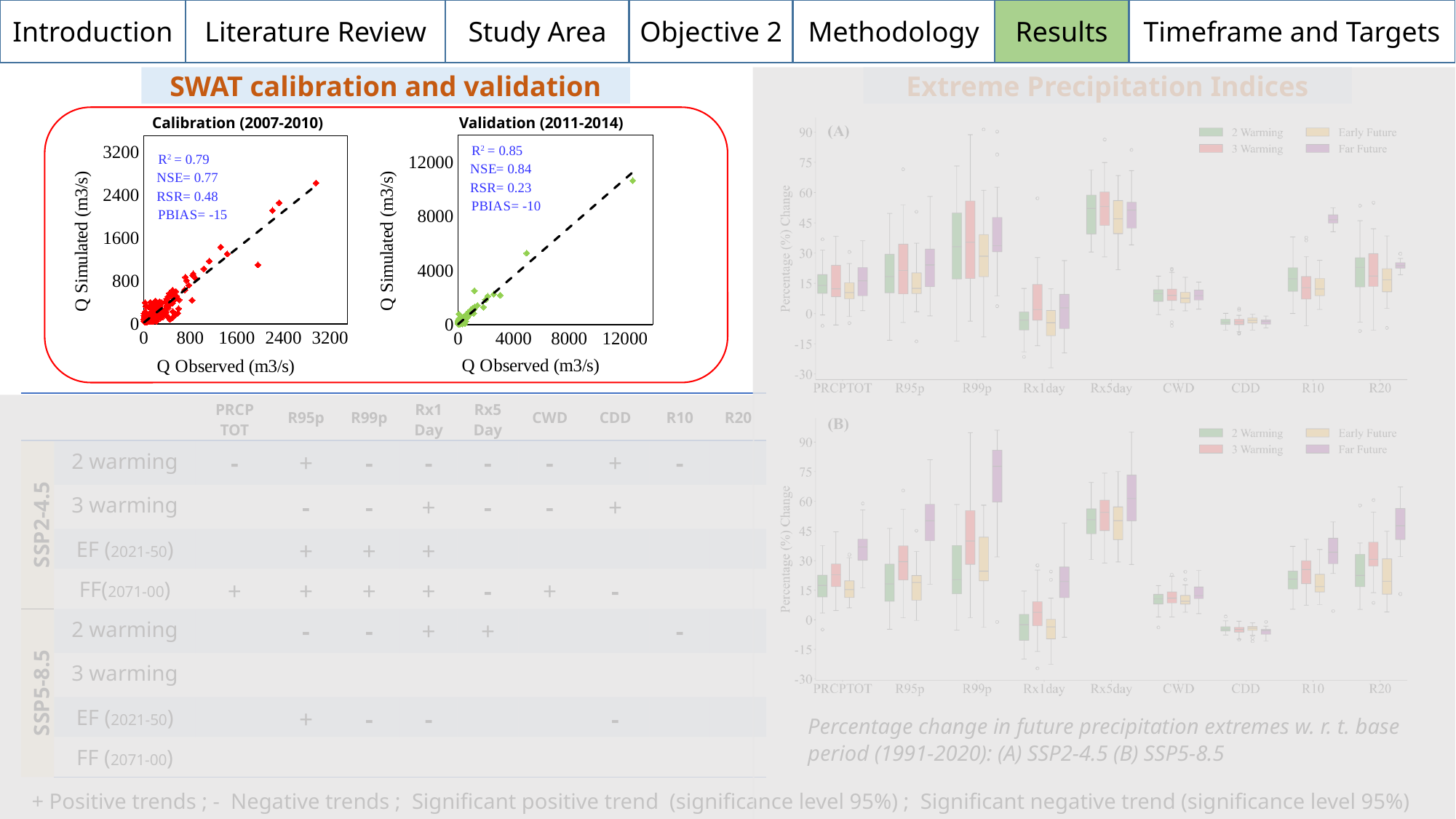
On the Validation (2011-2014) chart, what is the highest tick value shown on the Q Observed axis? 12000 On the Calibration (2007-2010) chart, what is the highest tick value shown on the Q Simulated axis? 3200 On the Validation (2011-2014) chart, what is the RSR value shown? 0.23 Which chart shows the higher R² value, Calibration (2007-2010) or Validation (2011-2014)? Validation (2011-2014) On the Calibration (2007-2010) chart, what is the R² value shown? 0.79 What is the y-axis label on the Calibration (2007-2010) chart? Q Simulated (m3/s) On the Validation (2011-2014) chart, what is the NSE value shown? 0.84 How many series does the legend of box plot (B) on the right of the slide list? 4 What kind of chart is the Calibration (2007-2010) chart? scatter chart How many precipitation indices are listed along the x axis of box plot (A) on the right of the slide? 9 What is the difference between the NSE values of the Validation (2011-2014) and Calibration (2007-2010) charts? 0.07 On the Calibration (2007-2010) chart, what is the PBIAS value shown? -15